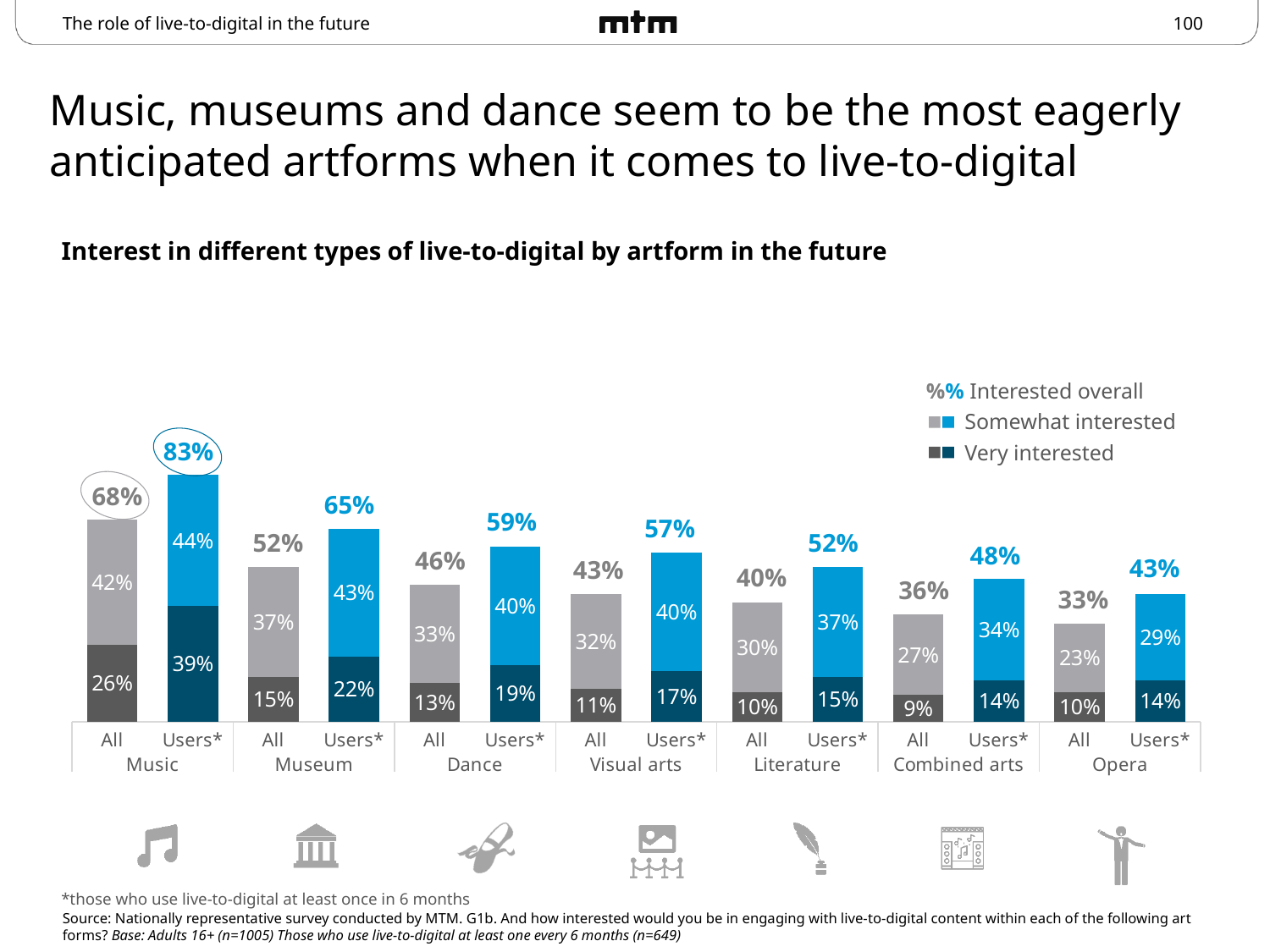
What type of chart is shown on the slide? Stacked bar chart What is the overall interest percentage for Opera among Users*? 43% What is the total of the Visual arts All stacked bar (Somewhat interested plus Very interested)? 43% Which bar has the lowest overall interest percentage? Opera All (33%) Which bar has the highest overall interest percentage? Music Users* (83%) Which is larger: the 'Very interested' value for Literature Users* or for Combined arts Users*? Literature Users* (15%) How many entries does the legend list? 3 Do the overall interest values for the 'All' bars rise or fall moving from Music to Opera along the x axis? Fall What is the difference between the overall interest for Museum Users* and Museum All? 13 percentage points How many artforms are shown on the x axis? 7 What is the 'Somewhat interested' value for Dance among All adults? 33% What is the 'Very interested' value for Music among Users*? 39%